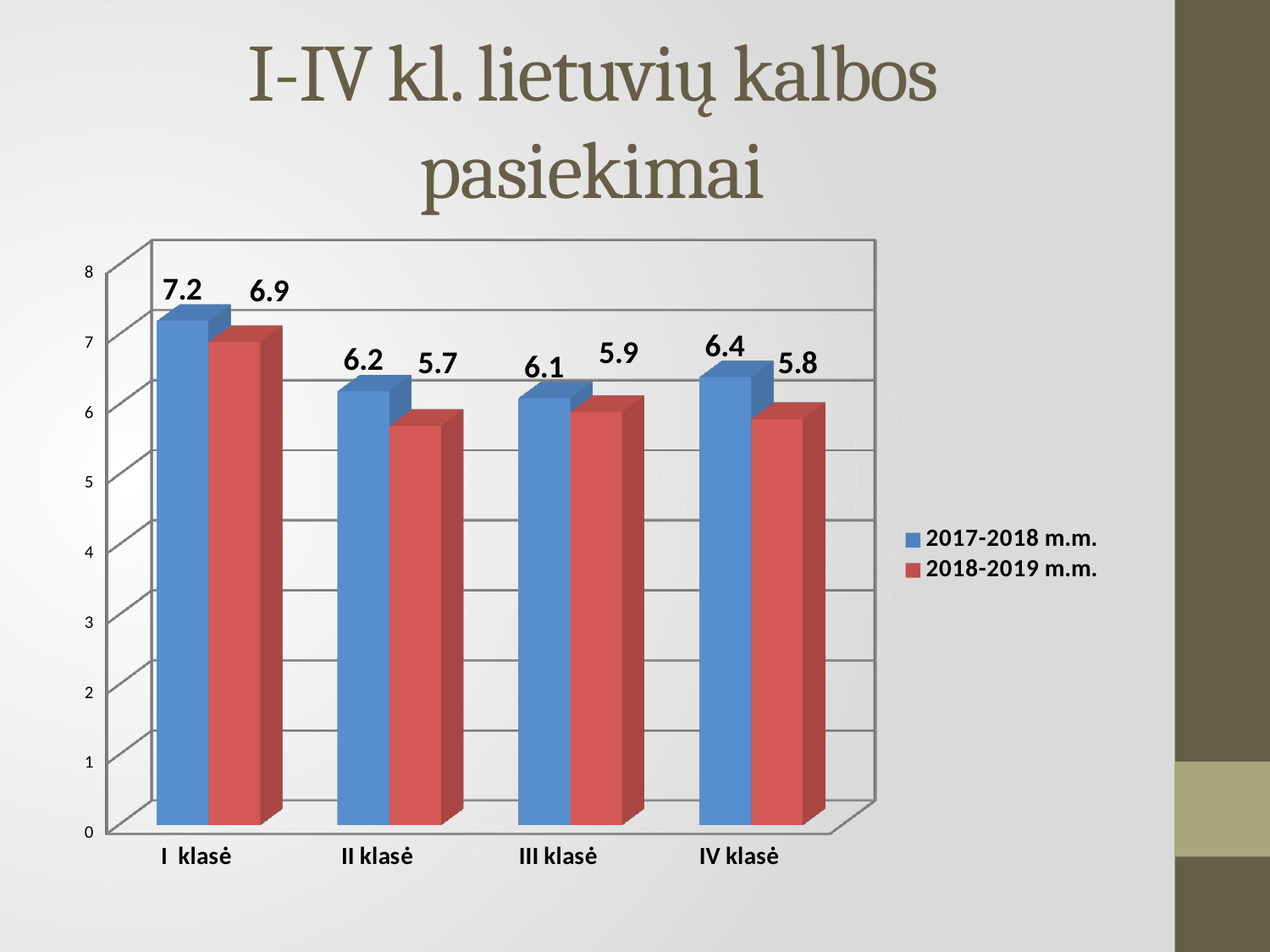
What is the difference between the 2017-2018 m.m. and 2018-2019 m.m. values for II klasė? 0.5 What kind of chart is shown on the slide? bar chart Which class has the lowest value in the 2017-2018 m.m. series? III klasė How many classes are shown on the x axis? 4 Which is larger for IV klasė: the 2017-2018 m.m. value or the 2018-2019 m.m. value? 2017-2018 m.m. How many series does the legend list? 2 What is the value for II klasė in the 2018-2019 m.m. series? 5.7 What is the value for IV klasė in the 2017-2018 m.m. series? 6.4 What is the title of the chart on the slide? I-IV kl. lietuvių kalbos pasiekimai What is the value for III klasė in the 2018-2019 m.m. series? 5.9 Which class has the highest value in the 2018-2019 m.m. series? I klasė What is the value for I klasė in the 2017-2018 m.m. series? 7.2